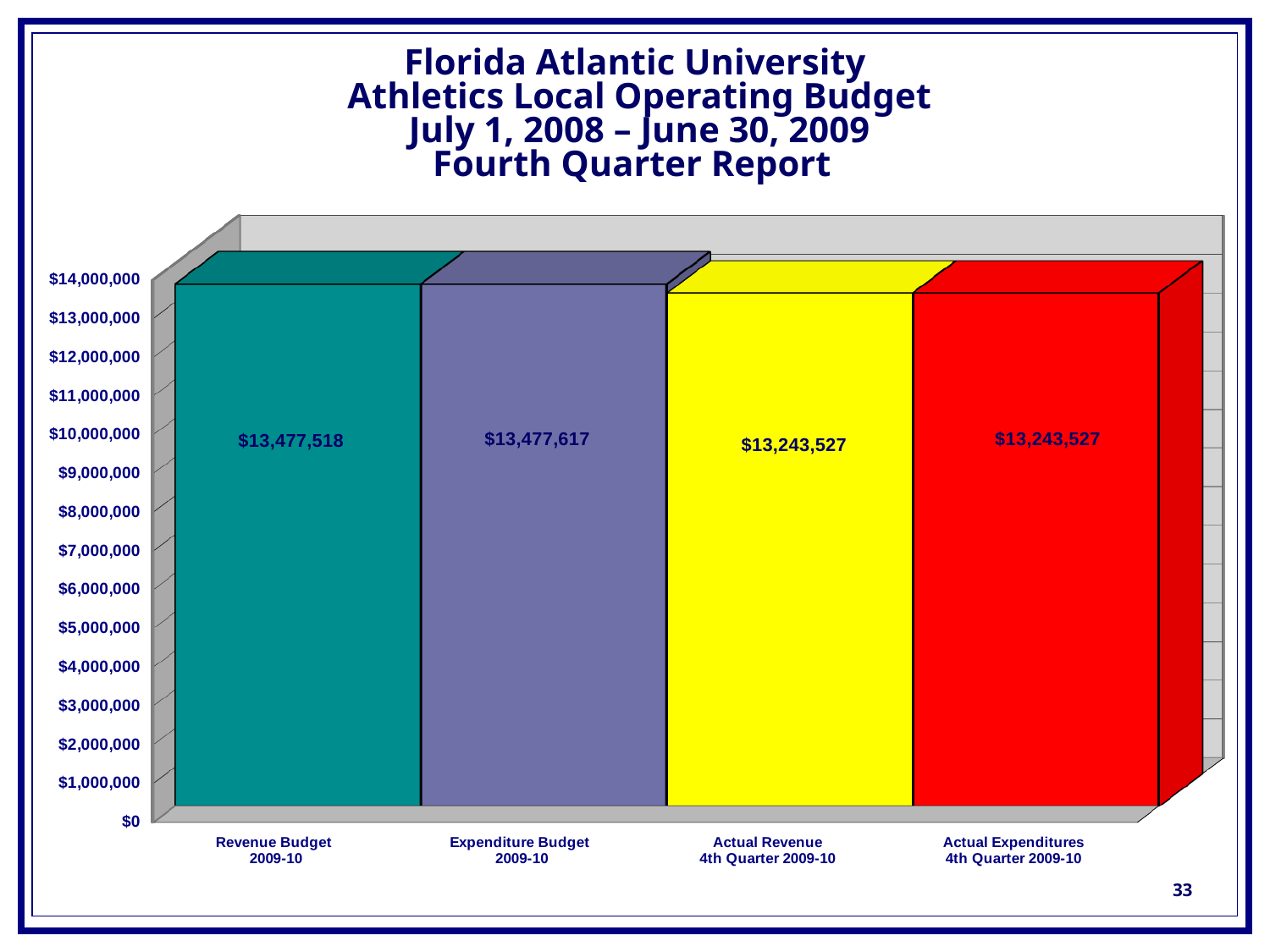
What is the difference between Expenditure Budget 2009-10 and Revenue Budget 2009-10? $99 How many bars are shown in the chart? 4 Is the value for Actual Revenue 4th Quarter 2009-10 greater or less than $13,000,000? greater What is the value for Revenue Budget 2009-10? $13,477,518 What is the difference between Revenue Budget 2009-10 and Actual Revenue 4th Quarter 2009-10? $233,991 What is the value for Actual Revenue 4th Quarter 2009-10? $13,243,527 What is the value for Actual Expenditures 4th Quarter 2009-10? $13,243,527 Is the value for Revenue Budget 2009-10 greater or less than $14,000,000? less What kind of chart is shown on the slide? Bar chart What is the value for Expenditure Budget 2009-10? $13,477,617 Which is larger, Revenue Budget 2009-10 or Actual Revenue 4th Quarter 2009-10? Revenue Budget 2009-10 What is the difference between Expenditure Budget 2009-10 and Actual Expenditures 4th Quarter 2009-10? $234,090